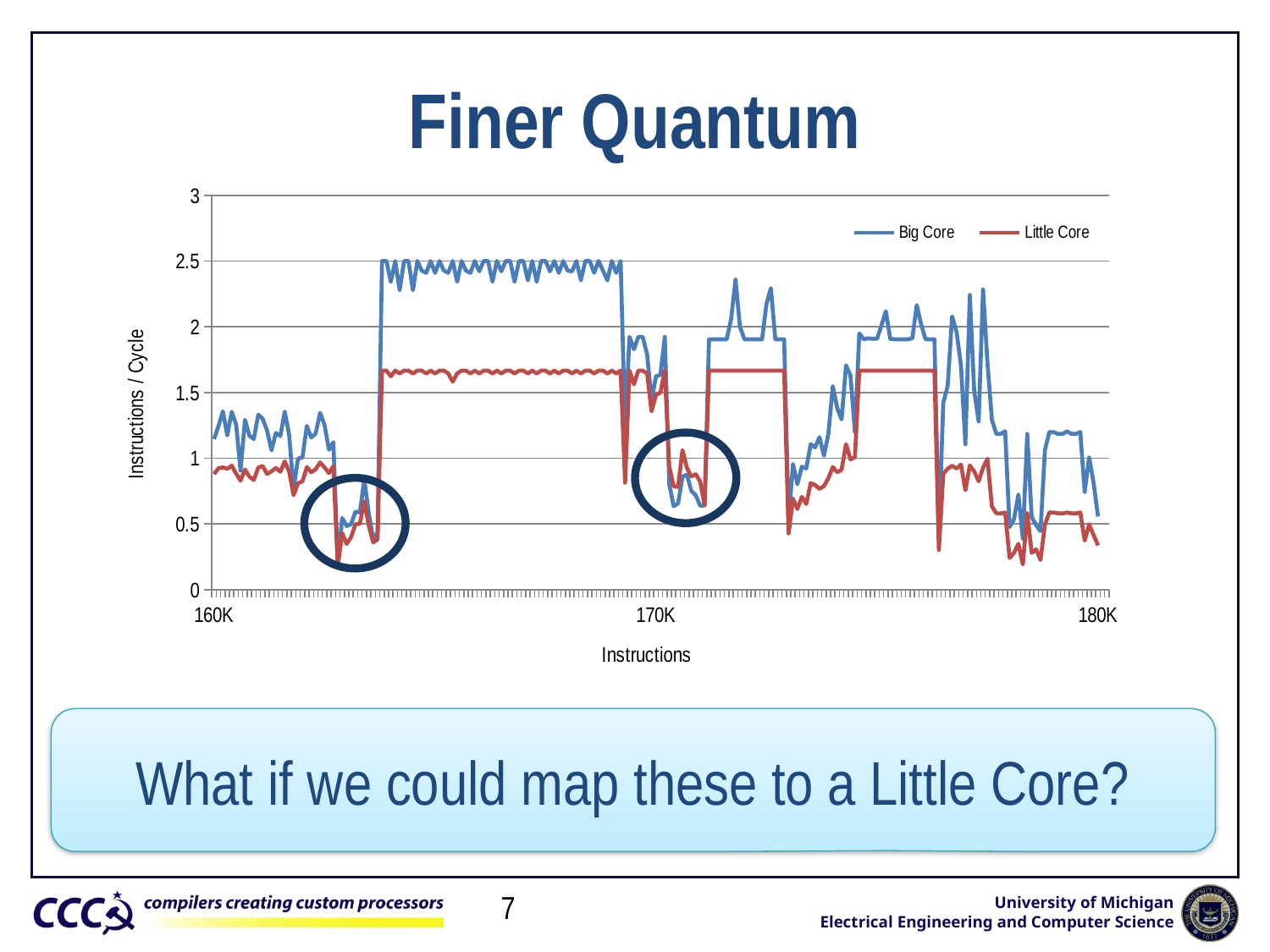
What is the label of the chart's y axis? Instructions / Cycle Is the Little Core value at around 165K instructions greater or less than 2? less Is the Little Core value at around 165K instructions greater or less than 1.5? greater Which series reaches the highest value anywhere on the chart, Big Core or Little Core? Big Core What kind of chart is shown on the slide? line chart At around 165K instructions, which series has the higher value, Big Core or Little Core? Big Core How many series does the chart's legend list? 2 Is the Big Core value at around 165K instructions greater or less than 2? greater What are the two series named in the chart's legend? Big Core and Little Core What is the highest value shown on the chart's y axis? 3